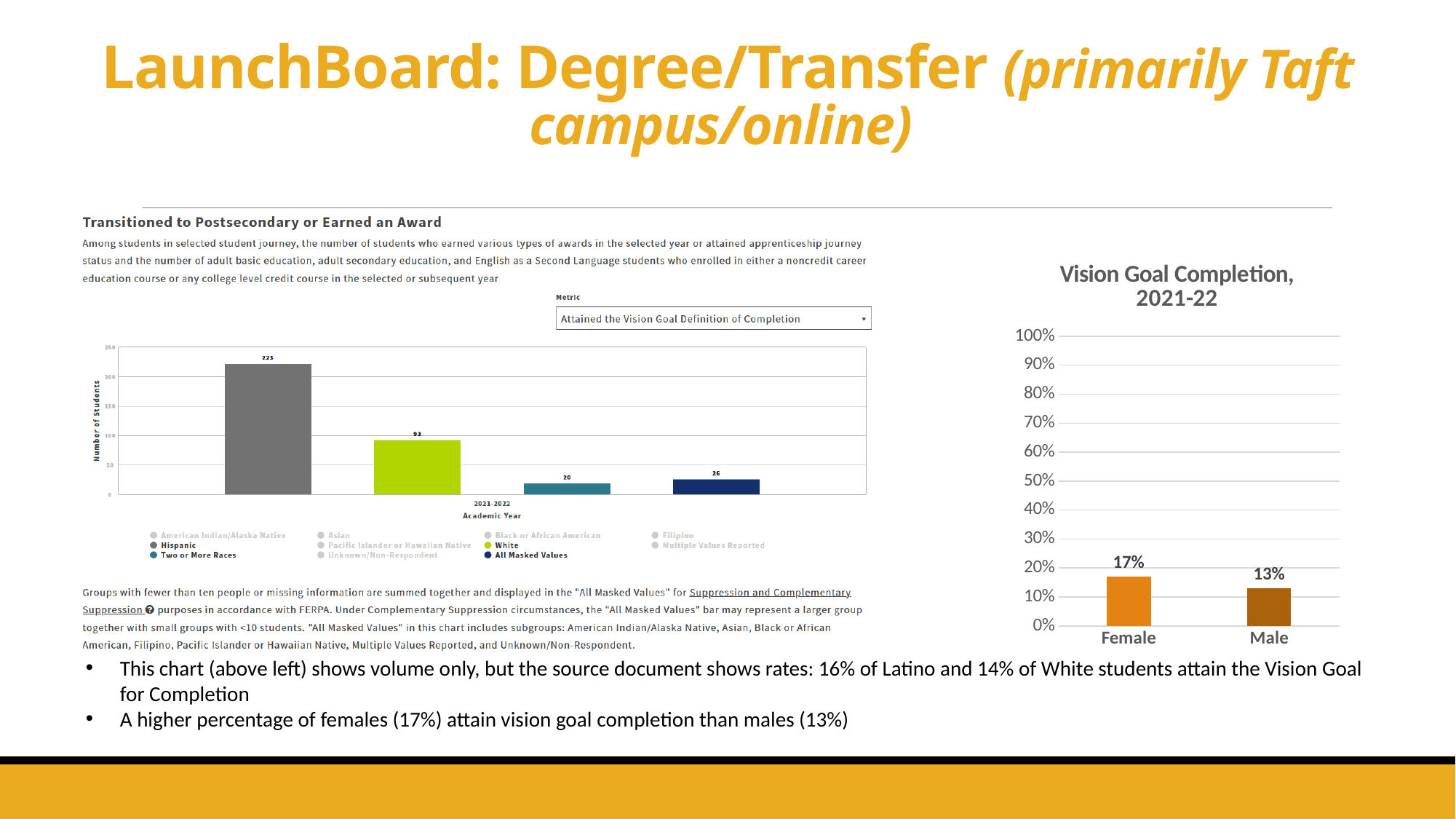
In the 'Transitioned to Postsecondary or Earned an Award' chart, what is the number of students for Hispanic? 223 What kind of chart is the 'Vision Goal Completion, 2021-22' chart? Bar chart In the 'Vision Goal Completion, 2021-22' chart, what is the difference between the Female and Male values? 4% In the 'Vision Goal Completion, 2021-22' chart, what is the value for Female? 17% In the 'Vision Goal Completion, 2021-22' chart, what is the value for Male? 13% In the 'Vision Goal Completion, 2021-22' chart, how many categories are shown on the x axis? 2 In the 'Transitioned to Postsecondary or Earned an Award' chart, which is larger: All Masked Values or Two or More Races? All Masked Values In the 'Transitioned to Postsecondary or Earned an Award' chart, what is the difference between the Hispanic and White bars? 130 In the 'Transitioned to Postsecondary or Earned an Award' chart, what is the number of students for White? 93 In the 'Transitioned to Postsecondary or Earned an Award' chart, what academic year is shown on the x axis? 2021-2022 In the 'Transitioned to Postsecondary or Earned an Award' chart, which group has the lowest number of students? Two or More Races In the 'Vision Goal Completion, 2021-22' chart, which category has the higher value? Female